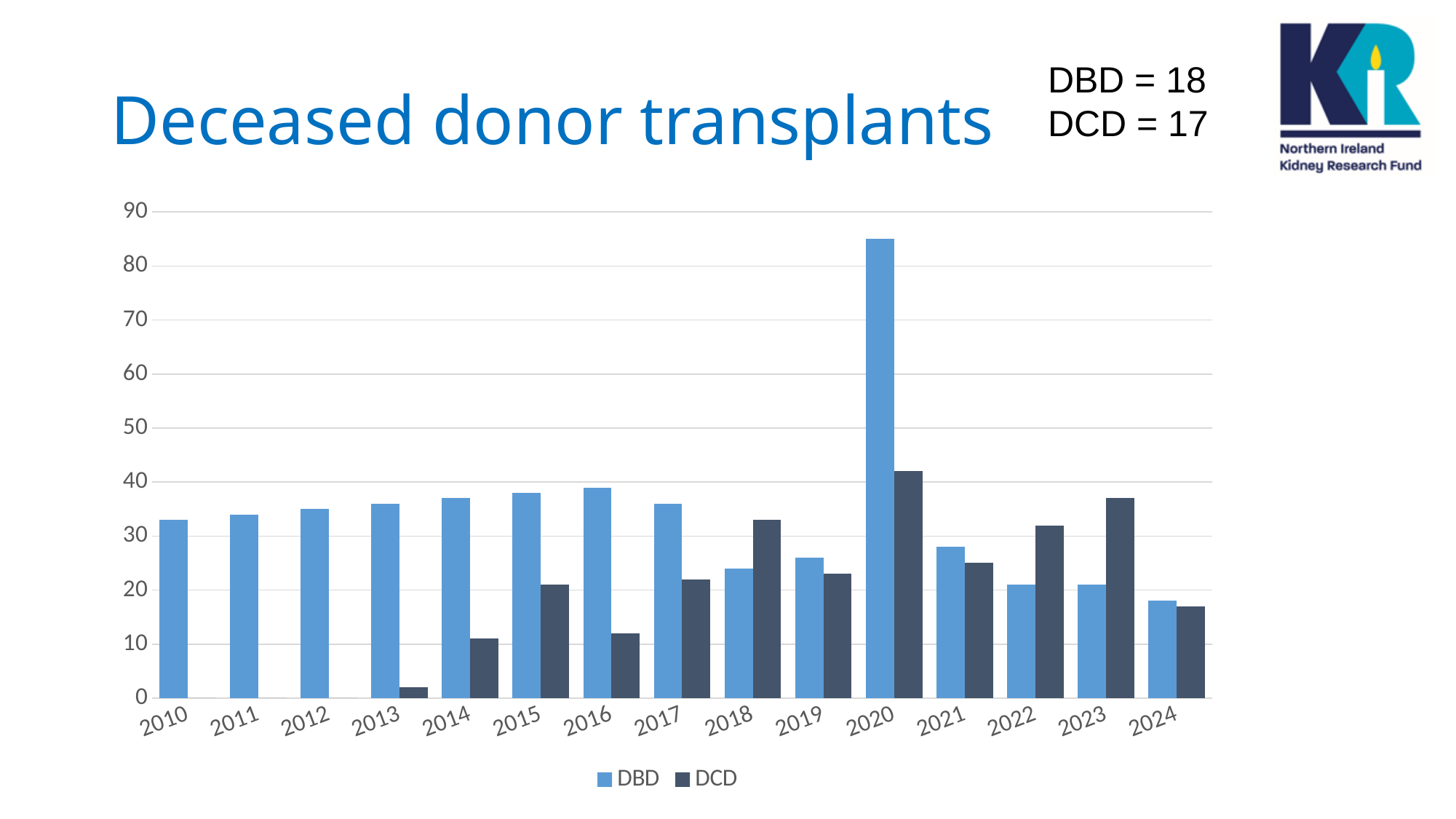
In which year is the DBD value highest? 2020 What kind of chart is shown on the slide? bar chart In which year is the DCD value highest? 2020 Is the DCD value for 2013 greater or less than 10? less In 2023, which is larger, DBD or DCD? DCD How many series does the legend list? 2 How many years are shown on the x axis? 15 In which year is the DBD value lowest? 2024 Is the DBD value for 2020 greater or less than 80? greater Is the DCD value for 2023 greater or less than 30? greater What is the title of the chart? Deceased donor transplants Do the DBD values rise or fall from 2010 to 2016? rise